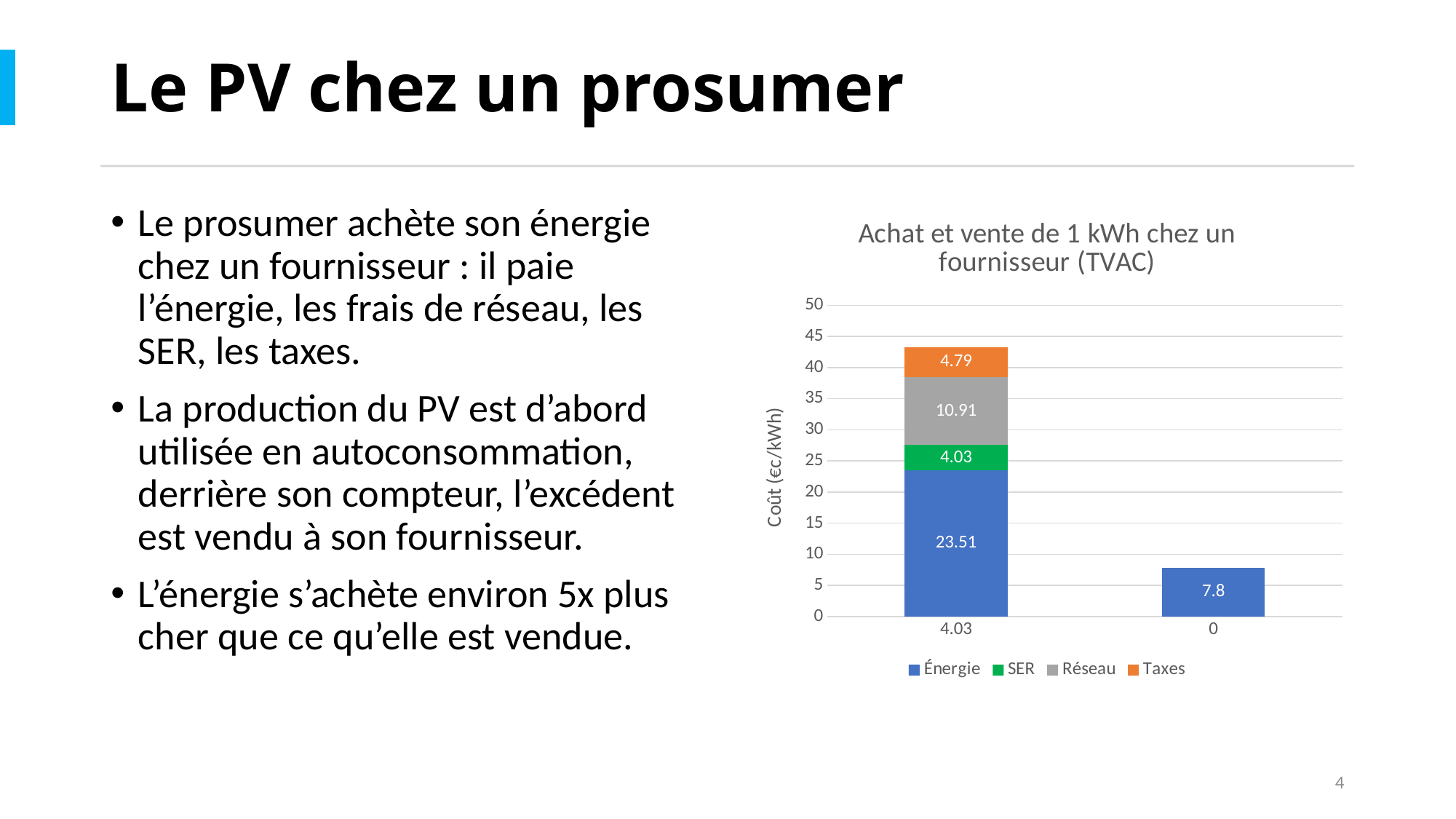
What is the label of the y axis? Coût (€c/kWh) What is the title of the chart? Achat et vente de 1 kWh chez un fournisseur (TVAC) What is the difference between the Énergie value in the left bar and the Énergie value in the right bar? 15.71 How many series does the chart legend list? 4 How many bars (categories) are plotted on the x axis? 2 Which series has the largest segment in the left bar (category labelled 4.03)? Énergie What is the Énergie value in the right bar (category labelled 0)? 7.8 What is the Réseau value in the left bar (category labelled 4.03)? 10.91 What is the Taxes value in the left bar (category labelled 4.03)? 4.79 What is the total of the stacked left bar (category labelled 4.03)? 43.24 What type of chart is shown on the slide? stacked bar chart What is the Énergie value in the left bar (category labelled 4.03)? 23.51